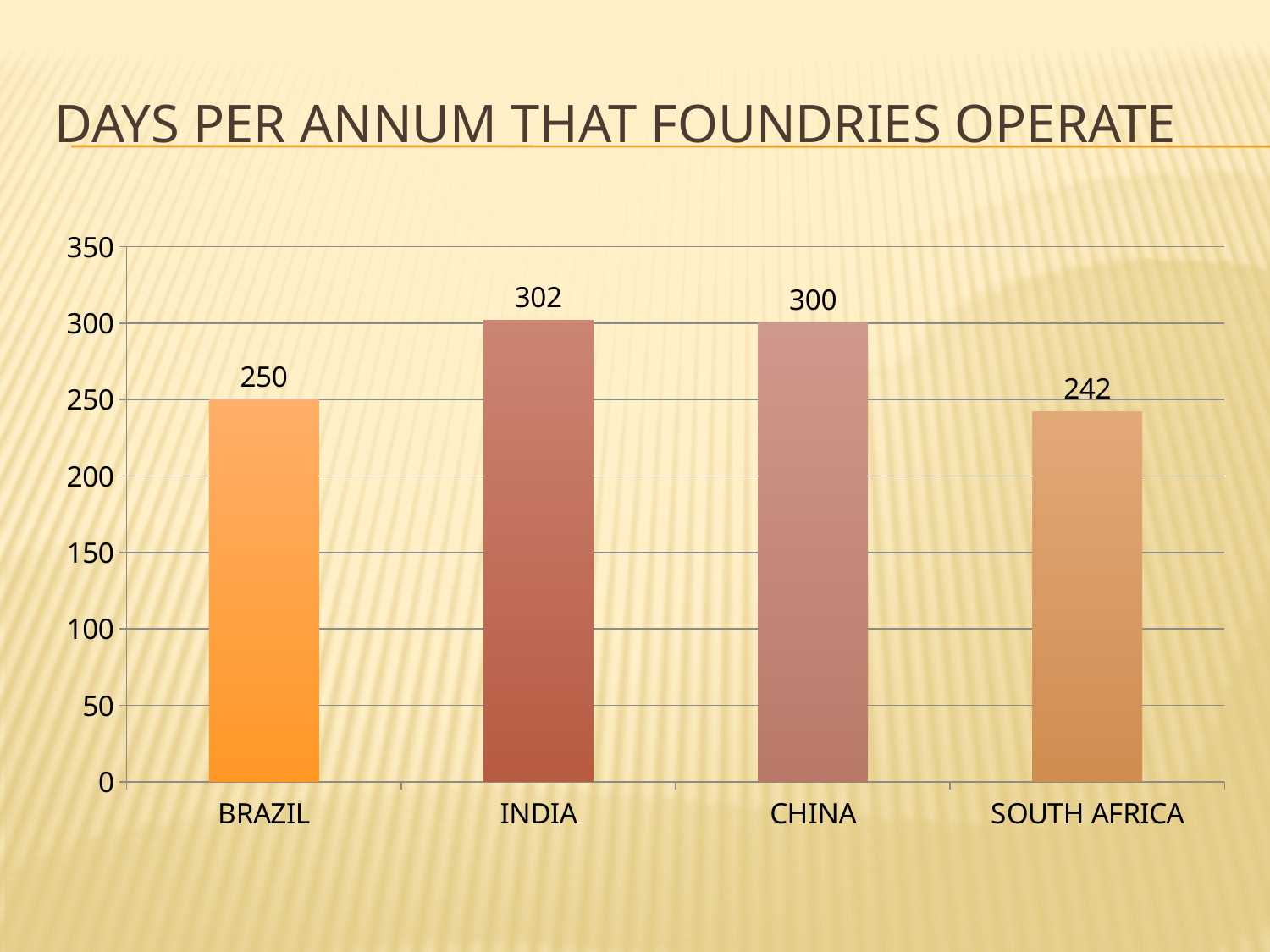
What is the difference between the values for China and Brazil? 50 Which has a larger value, Brazil or China? China How many days per annum do foundries operate in Brazil? 250 What is the value shown for India? 302 What is the difference between the values for India and South Africa? 60 Which country has the lowest number of operating days per annum? South Africa What is the title of the slide? DAYS PER ANNUM THAT FOUNDRIES OPERATE What kind of chart is shown on the slide? Bar chart What is the value shown for South Africa? 242 Is the value for South Africa greater or less than 250? less Which country has the highest number of operating days per annum? India How many countries are shown on the chart? 4